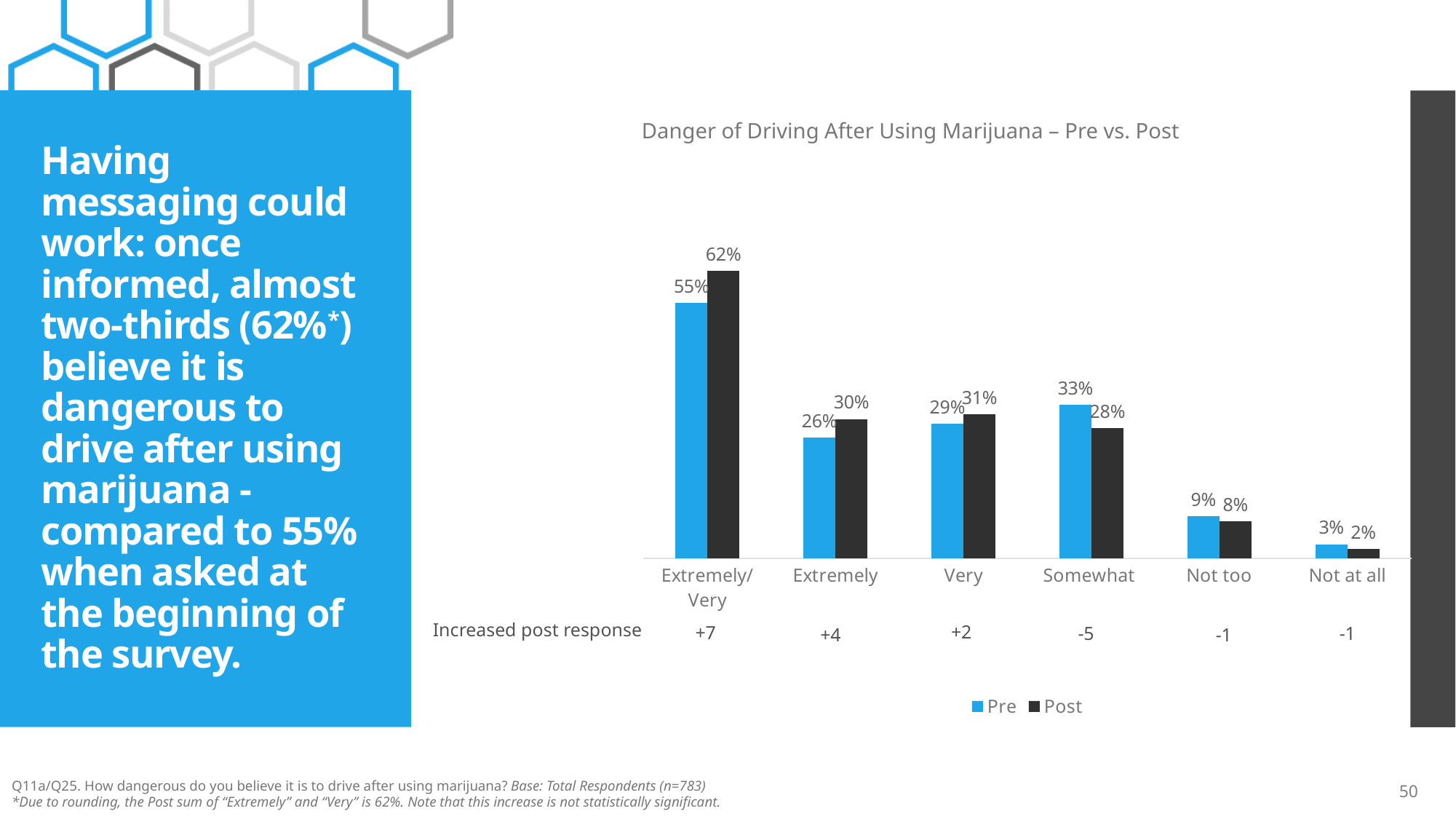
What is the difference between the Post and Pre values for the Extremely/Very category? 7 percentage points What is the title of the chart? Danger of Driving After Using Marijuana – Pre vs. Post What is the Pre value for the Somewhat category? 33% What kind of chart is shown on the slide? Bar chart What is the Post value for the Not too category? 8% Which category has the highest Pre value? Extremely/Very Which is larger for the Somewhat category, the Pre value or the Post value? Pre Which colour represents the Post series in the chart? Dark grey/black How many series does the legend list? 2 Which category has the lowest Post value? Not at all What is the Post value for the Extremely/Very category? 62% How many categories are shown on the x axis? 6